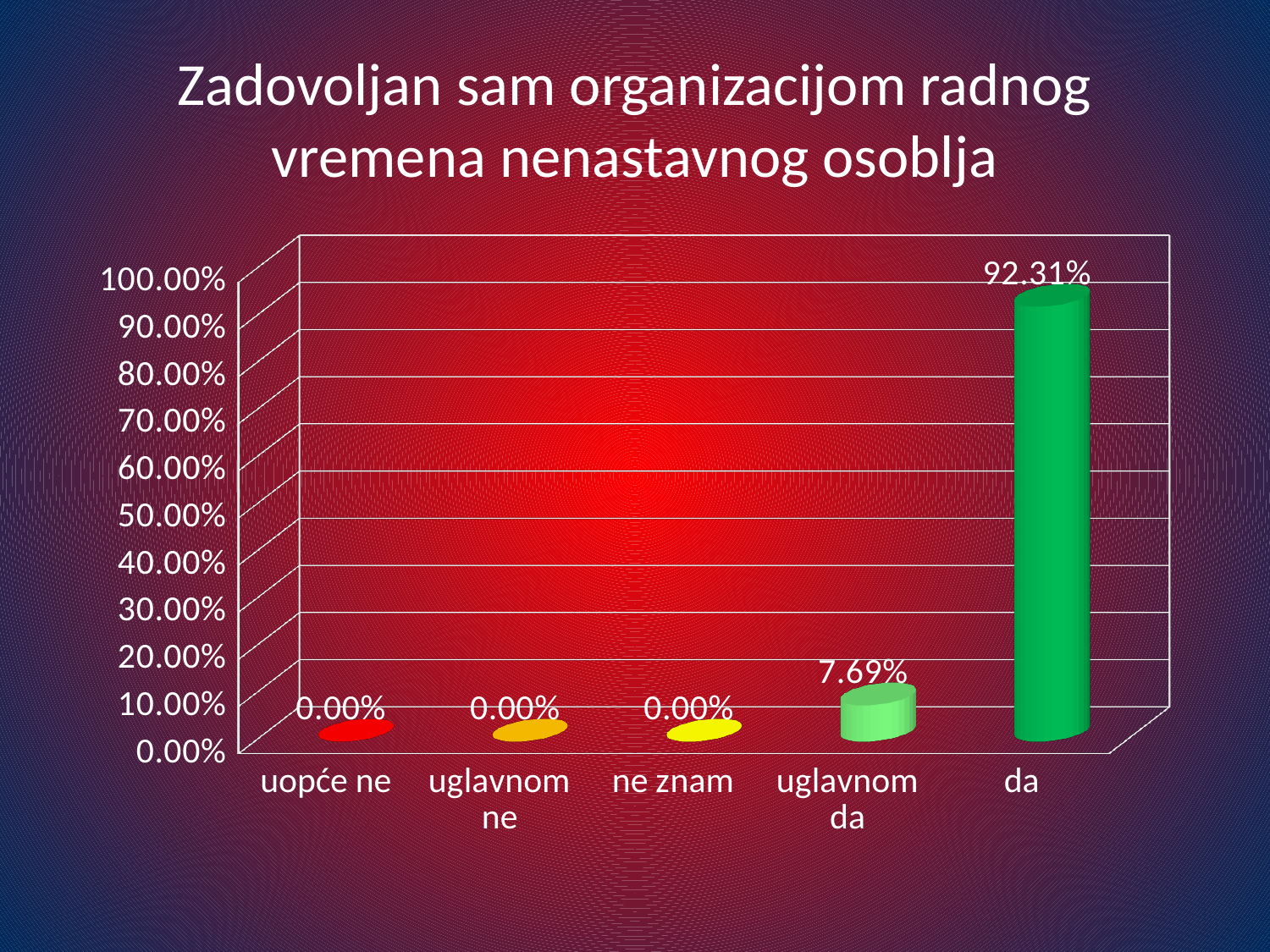
What kind of chart is shown on the slide? bar chart Do the values rise or fall from left to right along the x axis? rise Which category has the highest value? da What is the difference between the values for "da" and "uglavnom da"? 84.62% What is the value for "ne znam"? 0.00% How many categories are shown on the x axis? 5 What is the value for "uglavnom da"? 7.69% What is the value for "da"? 92.31% What is the title of the chart? Zadovoljan sam organizacijom radnog vremena nenastavnog osoblja Which is larger, the value for "uglavnom da" or the value for "uopće ne"? uglavnom da Is the value for "da" greater or less than 90.00%? greater Is the value for "uglavnom da" greater or less than 10.00%? less